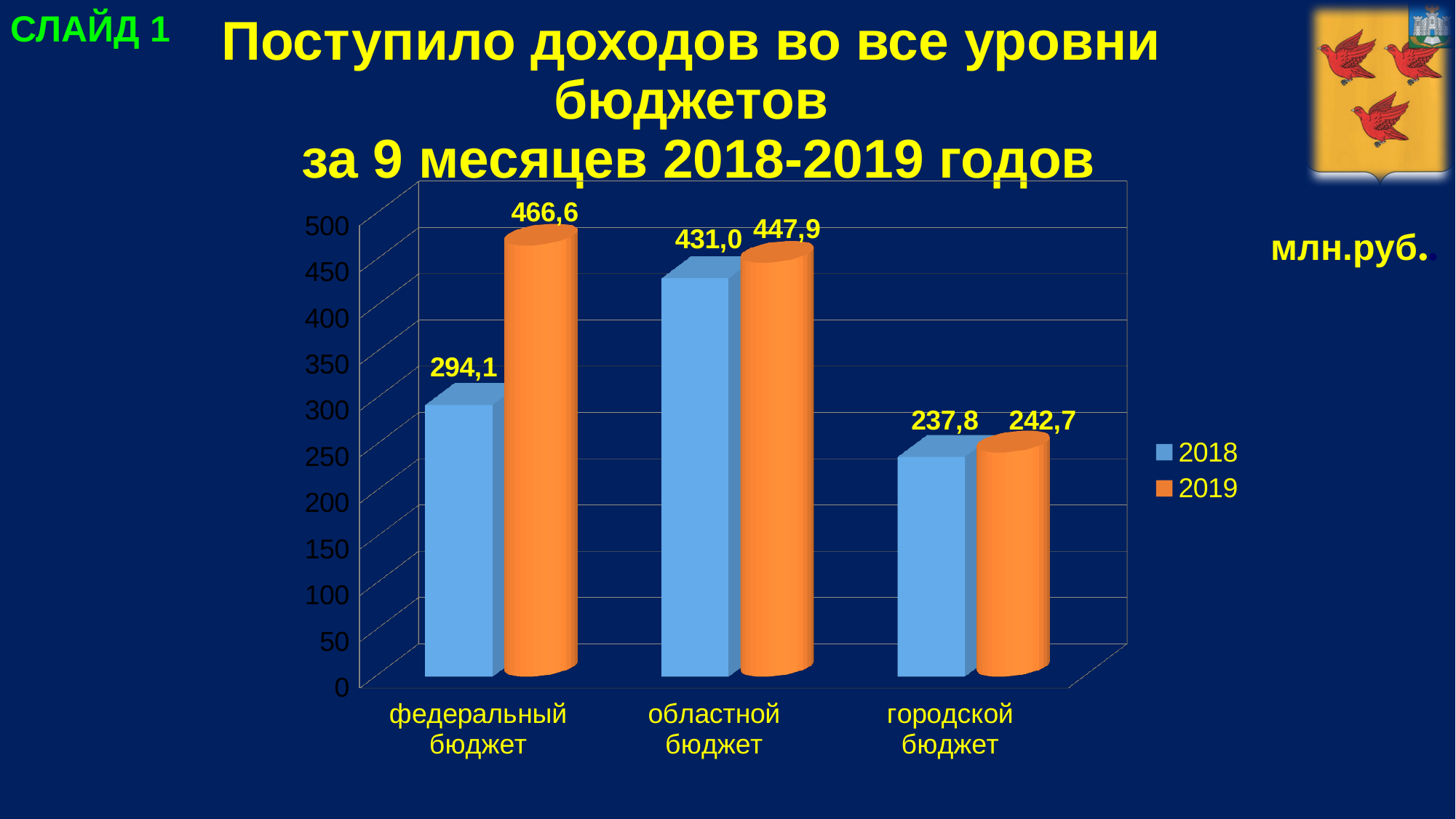
How many series does the legend list? 2 What is the 2019 value for городской бюджет? 242,7 How many categories are shown on the x axis? 3 What is the difference between the 2019 and 2018 values for федеральный бюджет? 172,5 Which is larger for областной бюджет: the 2018 value or the 2019 value? 2019 What is the 2019 value for областной бюджет? 447,9 Which category has the highest 2019 value? федеральный бюджет What is the difference between the 2019 and 2018 values for областной бюджет? 16,9 Is the 2018 value for федеральный бюджет greater or less than 300? less What kind of chart is shown on the slide? bar chart What is the 2018 value for федеральный бюджет? 294,1 Which category has the lowest 2018 value? городской бюджет